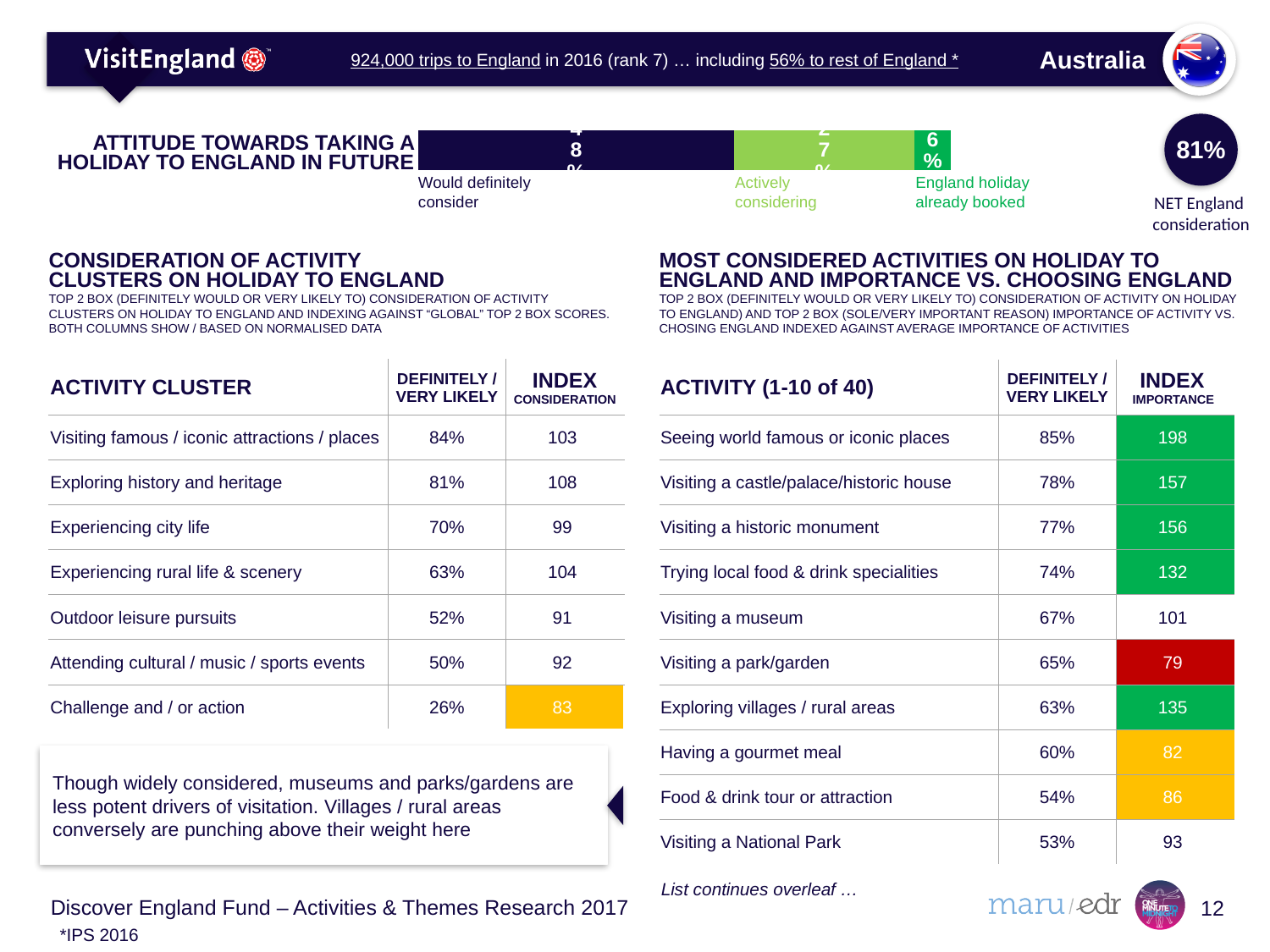
In the 'Attitude towards taking a holiday to England in future' chart, which is larger: 'Would definitely consider' or 'Actively considering'? Would definitely consider In the 'Attitude towards taking a holiday to England in future' chart, what colour is the 'Would definitely consider' segment? Dark blue In the 'Attitude towards taking a holiday to England in future' chart, which is larger: 'Actively considering' or 'England holiday already booked'? Actively considering What is the NET England consideration figure shown next to the 'Attitude towards taking a holiday to England in future' chart? 81% How many segments (categories) make up the stacked bar in the 'Attitude towards taking a holiday to England in future' chart? 3 In the 'Attitude towards taking a holiday to England in future' chart, what is the value for 'England holiday already booked'? 6% In the 'Attitude towards taking a holiday to England in future' chart, what colour is the 'Actively considering' segment? Light green What kind of chart is shown under the heading 'Attitude towards taking a holiday to England in future'? Bar chart In the 'Attitude towards taking a holiday to England in future' chart, which segment is the smallest? England holiday already booked In the 'Attitude towards taking a holiday to England in future' chart, which segment is the largest? Would definitely consider